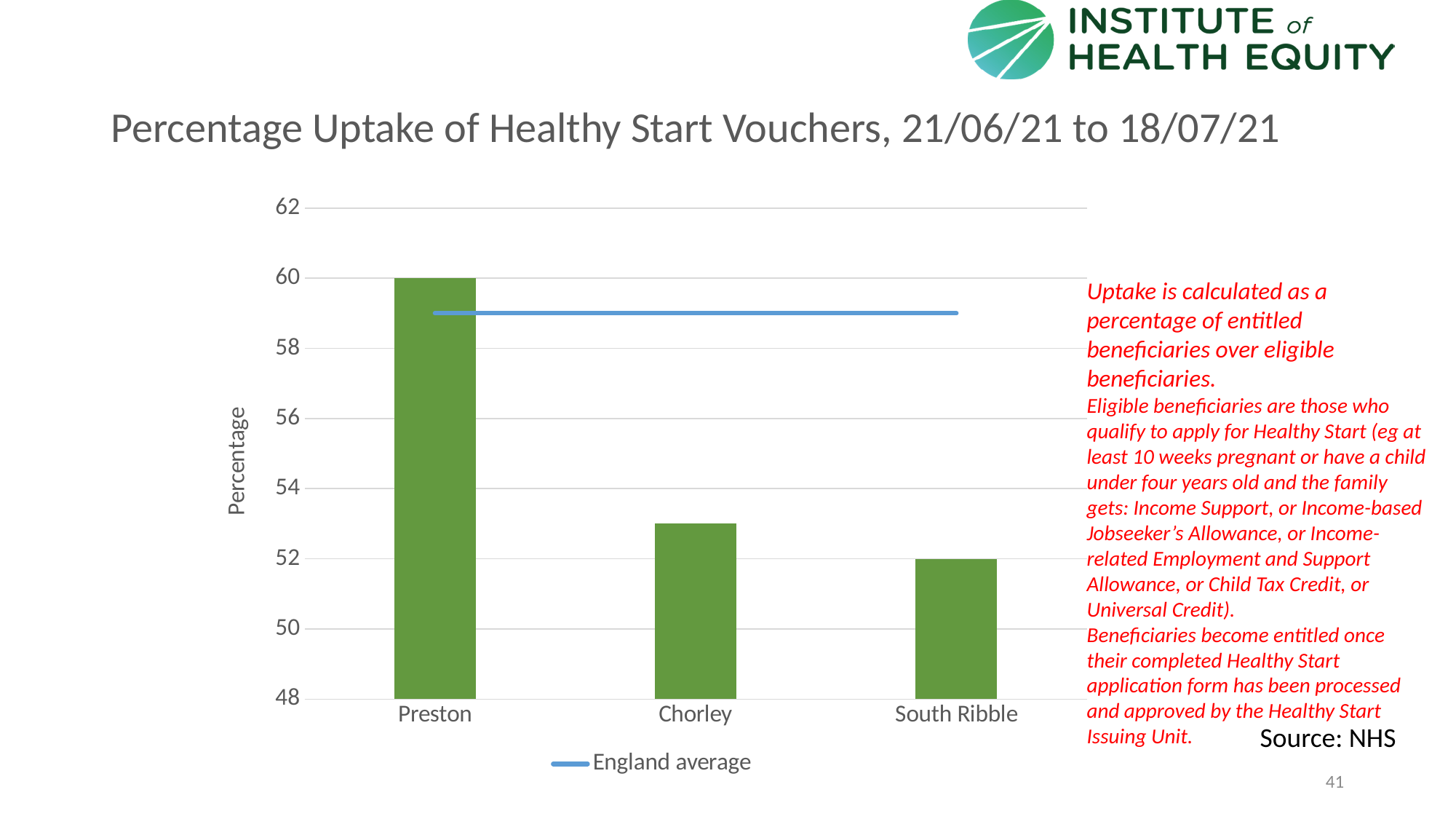
What is the percentage uptake for South Ribble? 52 Do the bar values rise or fall from left to right across the x axis? Fall What is the percentage uptake for Preston? 60 Which area has the lowest percentage uptake? South Ribble Which has the larger percentage uptake, Chorley or South Ribble? Chorley Is the England average line greater or less than 58? greater Which area has the highest percentage uptake? Preston What type of chart is shown on the slide? Bar and line chart (bars with an England average line) What entry does the legend list? England average How many areas are shown on the x axis? 3 What is the difference in percentage uptake between Preston and South Ribble? 8 Is the value for Chorley greater or less than 54? less